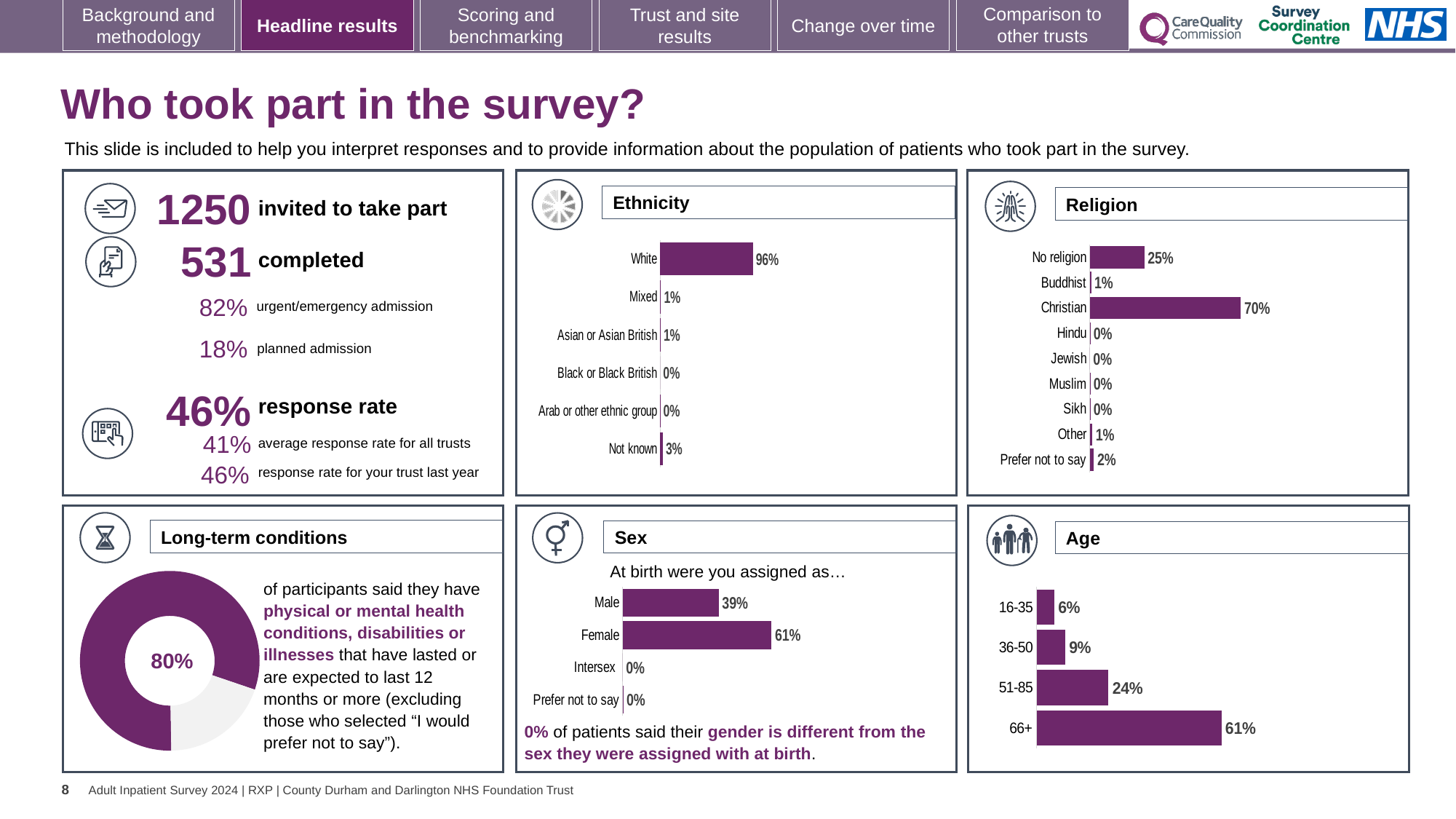
In the Sex chart, which is larger, Male or Female? Female In the Religion chart, which category has the highest value? Christian In the Sex chart, what is the difference between the Female and Male values? 22% In the Long-term conditions chart, what share of participants said they have long-term conditions? 80% What kind of chart is the Long-term conditions chart? doughnut chart In the Age chart, do the values rise or fall as age increases from 16-35 to 66+? rise In the Ethnicity chart, what percentage of respondents were White? 96% In the Age chart, what is the value for the 51-85 age group? 24% In the Age chart, which age group has the lowest value? 16-35 How many categories are shown in the Religion chart? 9 In the Religion chart, what is the value for No religion? 25% In the Religion chart, what is the difference between the Christian and No religion values? 45%